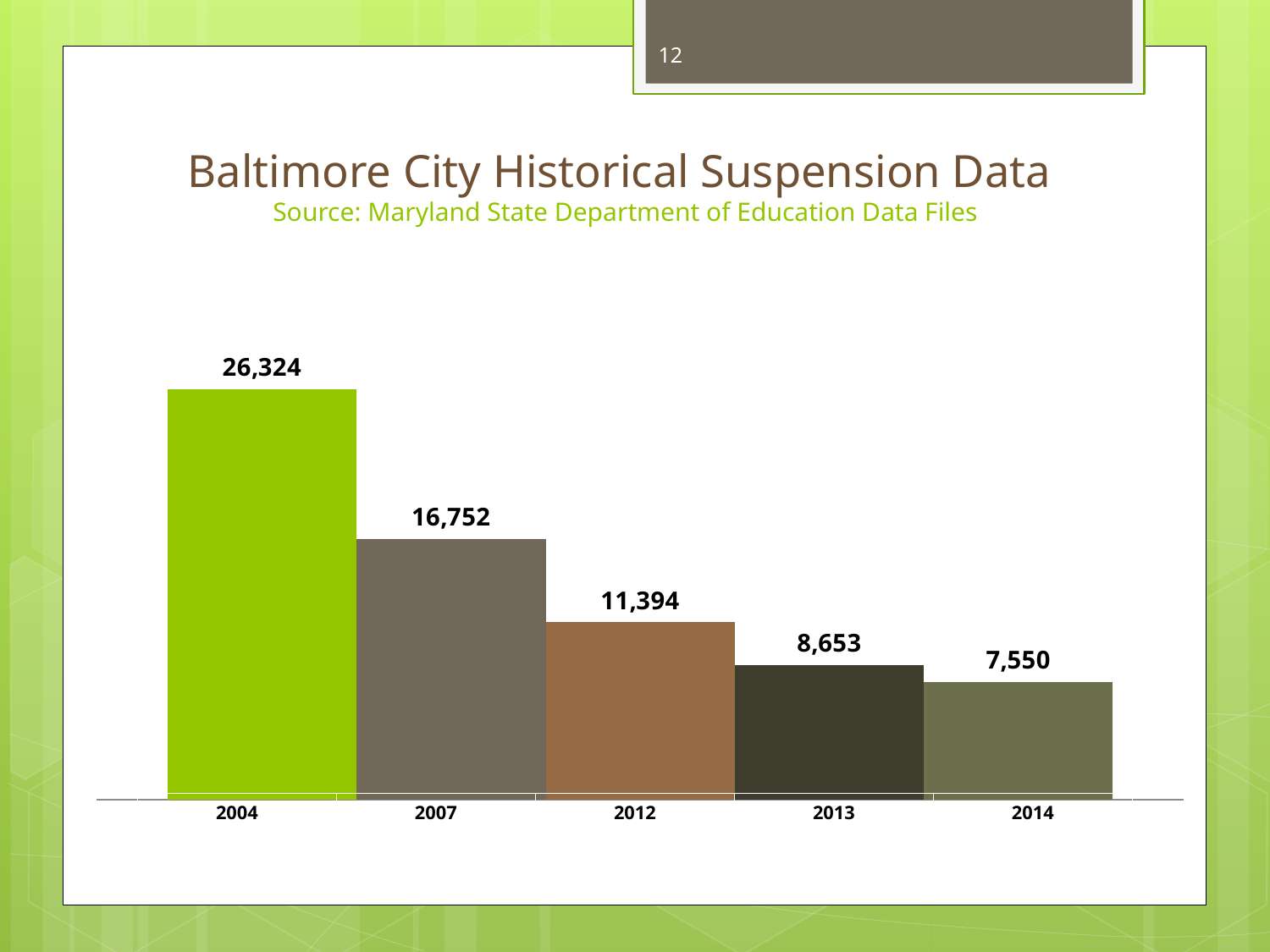
What kind of chart is shown on the slide? Bar chart What is the difference between the values for 2004 and 2007? 9,572 What is the value shown for 2012? 11,394 What is the value shown for 2014? 7,550 What is the title of the chart? Baltimore City Historical Suspension Data What is the value shown for 2004? 26,324 What is the difference between the values for 2013 and 2014? 1,103 How many years are shown on the chart? 5 Which year has the highest value? 2004 Which is larger, the value for 2007 or the value for 2012? 2007 Do the values rise or fall from 2004 to 2014? Fall Which year has the lowest value? 2014